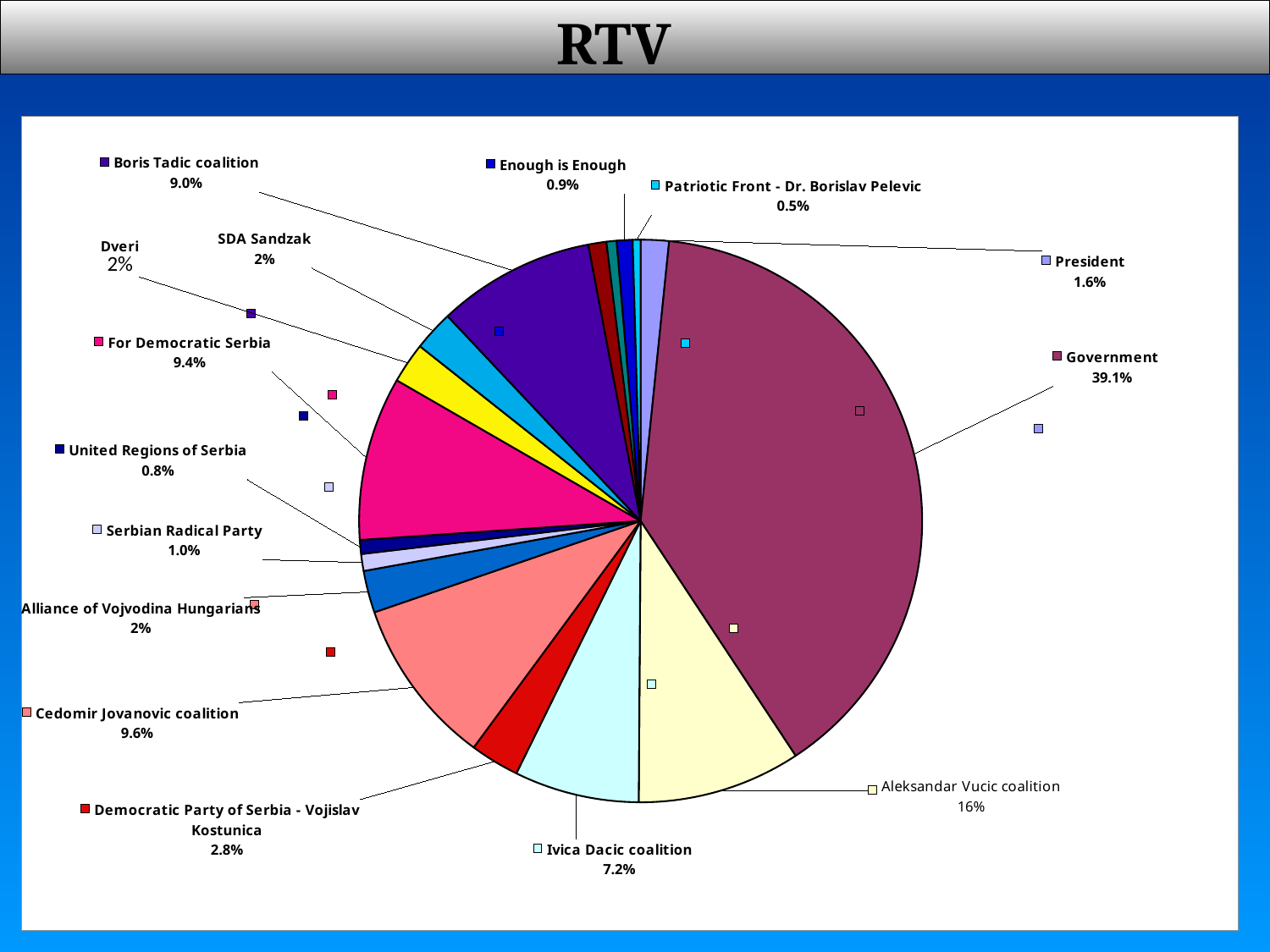
What is the value for Democratic Party of Serbia - Vojislav Kostunica? 2.8% What is the value for Aleksandar Vucic coalition? 16% Which is larger, the value for For Democratic Serbia or the value for Boris Tadic coalition? For Democratic Serbia What is the difference between the values for Government and Aleksandar Vucic coalition? 23.1% Which category has the smallest slice of the pie? Patriotic Front - Dr. Borislav Pelevic What type of chart is shown on the slide? pie chart How many categories are shown in the pie chart? 17 What is the value for Cedomir Jovanovic coalition? 9.6% What is the title of the slide? RTV What is the value for Ivica Dacic coalition? 7.2% Which category has the largest slice of the pie? Government What share of the pie does Government hold? 39.1%